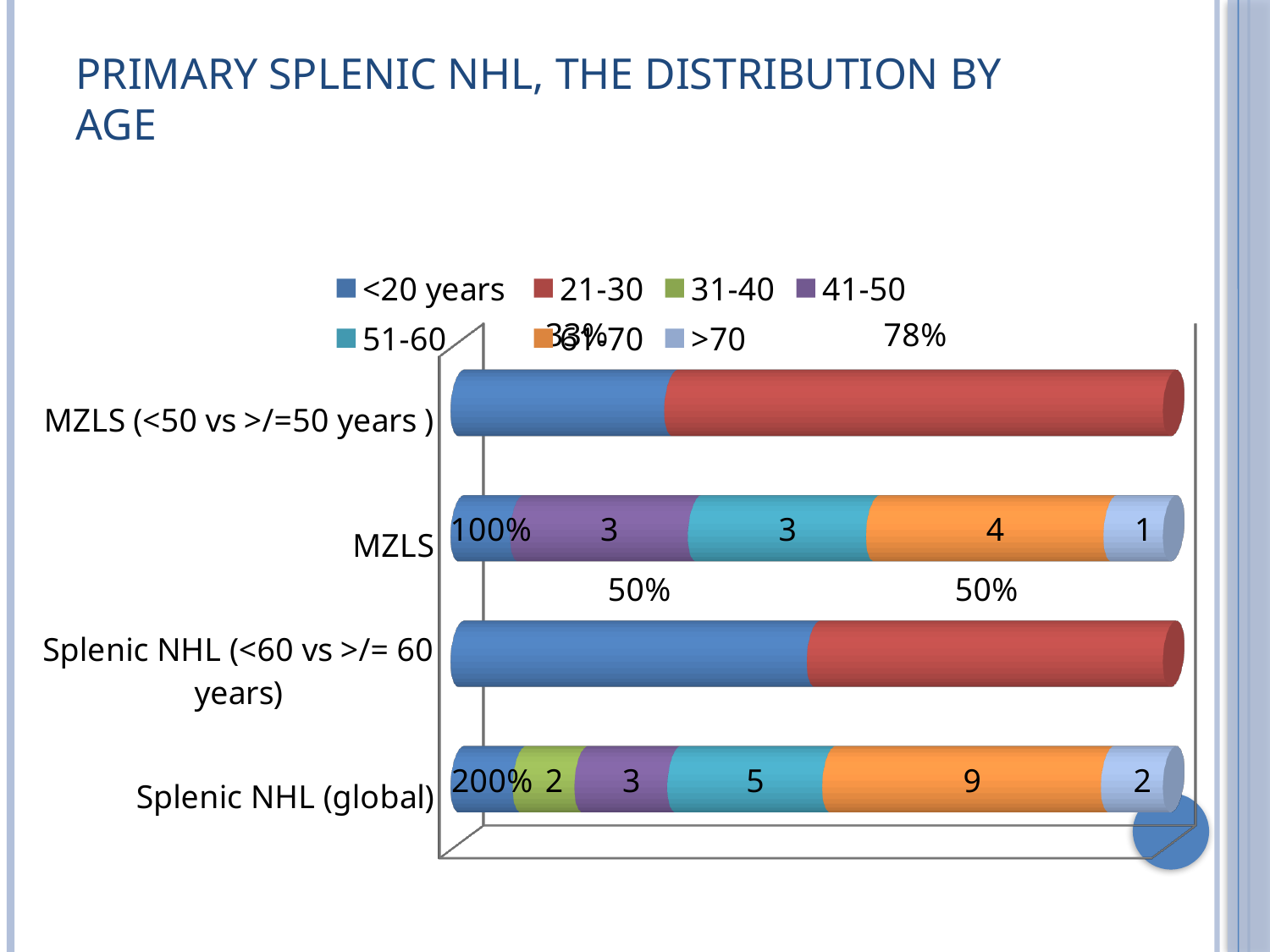
How many categories (bars) are plotted on the chart? 4 What percentage is labelled on the red segment of the MZLS (<50 vs >/=50 years) bar? 78% Which age group has the largest segment in the Splenic NHL (global) bar? 61-70 What is the difference between the 61-70 and 51-60 segments for Splenic NHL (global)? 4 What is the title of the chart slide? PRIMARY SPLENIC NHL, THE DISTRIBUTION BY AGE What is the value of the 61-70 segment for Splenic NHL (global)? 9 What kind of chart is shown on the slide? bar chart How many series does the legend list? 7 What is the value of the 51-60 segment for Splenic NHL (global)? 5 What is the value of the 61-70 segment for MZLS? 4 In the Splenic NHL (global) bar, which is larger: the 61-70 segment or the 51-60 segment? 61-70 What is the value of the >70 segment for MZLS? 1